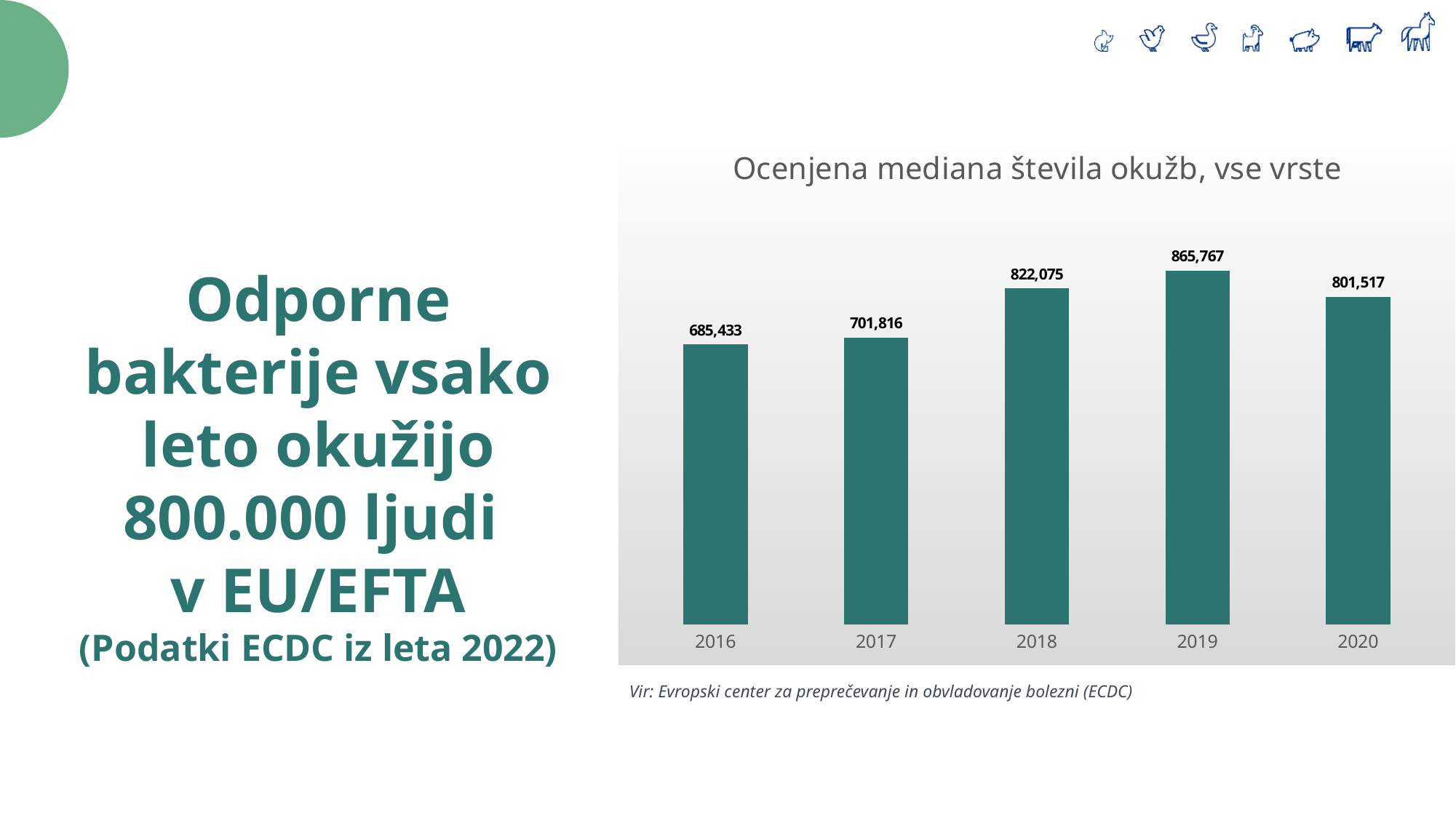
What is the value for 2020? 801,517 What is the difference between the values for 2017 and 2016? 16,383 Which year has the lowest value? 2016 Do the values rise or fall from 2016 to 2019? rise What is the difference between the values for 2019 and 2020? 64,250 Which is larger, the value for 2018 or the value for 2020? 2018 What is the title of the chart? Ocenjena mediana števila okužb, vse vrste What is the value for 2018? 822,075 What is the value for 2016? 685,433 How many years are shown on the x axis? 5 Which year has the highest value? 2019 What kind of chart is shown? bar chart